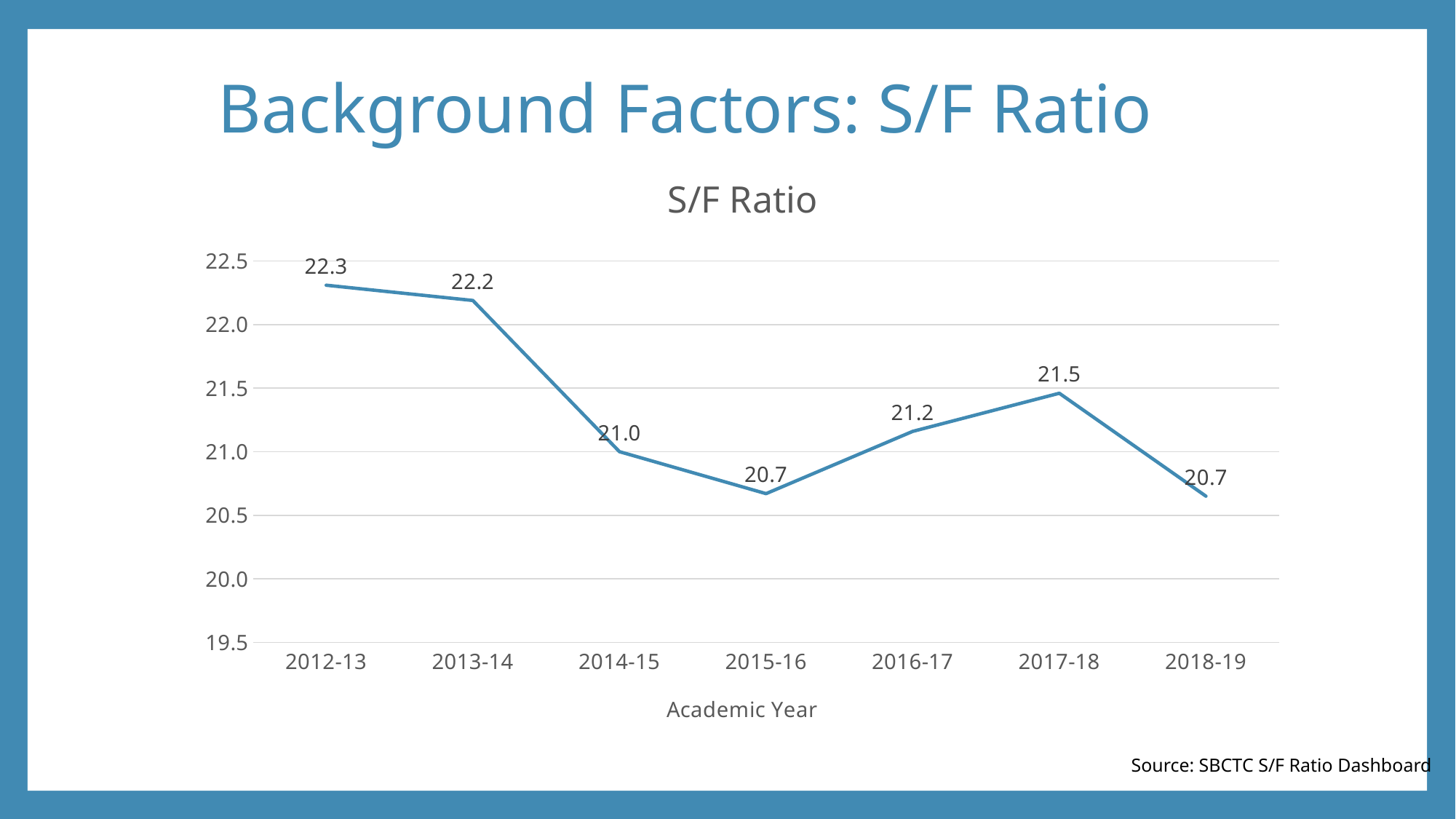
Which is larger, the S/F Ratio for 2013-14 or for 2016-17? 2013-14 What is the S/F Ratio for 2012-13? 22.3 What is the difference between the S/F Ratio in 2017-18 and in 2016-17? 0.3 What is the S/F Ratio for 2017-18? 21.5 What is the difference between the S/F Ratio in 2012-13 and in 2018-19? 1.6 What kind of chart is shown on the slide? Line chart How many academic years are plotted on the chart? 7 Which academic year has the highest S/F Ratio? 2012-13 What is the label of the x axis? Academic Year What is the S/F Ratio for 2015-16? 20.7 Does the S/F Ratio rise or fall from 2013-14 to 2015-16? Fall What is the S/F Ratio for 2014-15? 21.0